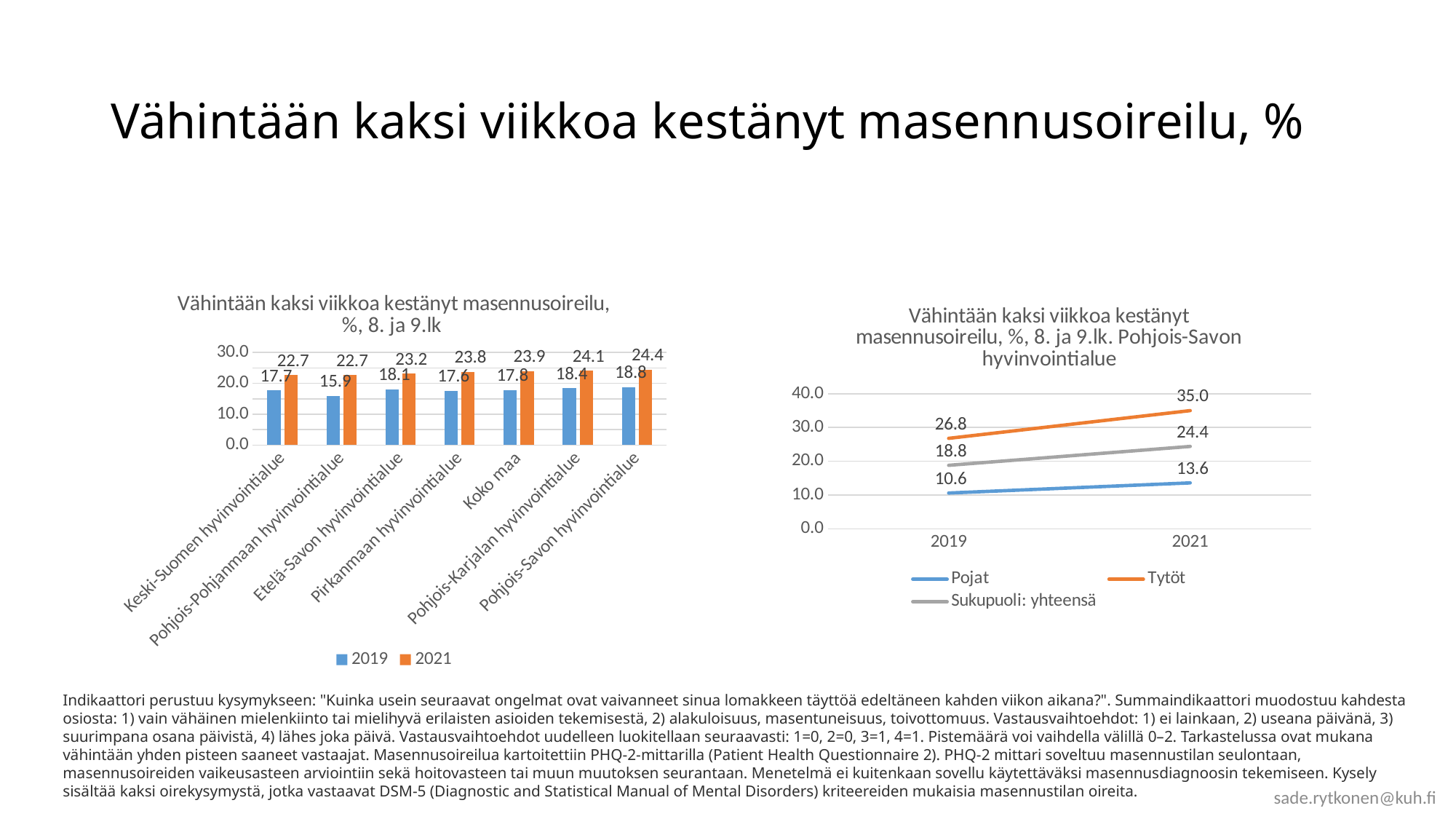
In the left bar chart, what is the difference between the 2021 and 2019 values for Koko maa? 6.1 How many categories are shown on the x axis of the left bar chart? 7 What kind of chart is the chart on the right of the slide? Line chart In the left bar chart, what is the 2019 value for Pohjois-Pohjanmaan hyvinvointialue? 15.9 In the left bar chart, what is the 2021 value for Pohjois-Savon hyvinvointialue? 24.4 How many series does the legend of the right line chart list? 3 In the right line chart, what is the difference between the Tytöt and Pojat values in 2019? 16.2 In the left bar chart, which category has the lowest 2019 value? Pohjois-Pohjanmaan hyvinvointialue In the left bar chart, which category has the highest 2021 value? Pohjois-Savon hyvinvointialue In the right line chart, what is the value for Tytöt in 2021? 35.0 In the right line chart, does the Pojat line rise or fall from 2019 to 2021? Rise How many series does the legend of the left bar chart list? 2